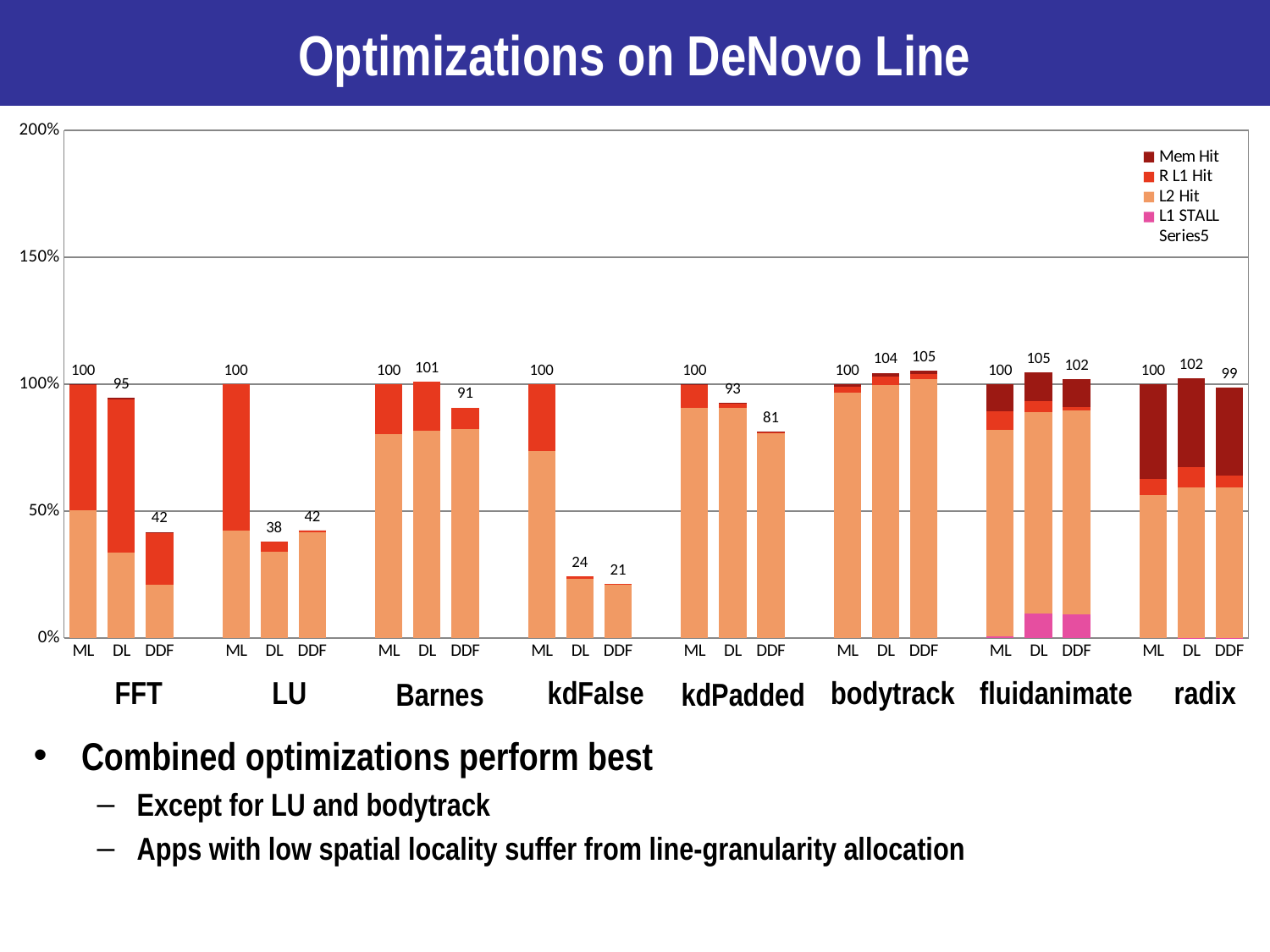
What is the total height of the DDF bar for FFT? 42 How many application groups are shown along the x axis? 8 How many series does the legend list? 5 For LU, which is larger: the DL total or the DDF total? DDF Within the kdPadded group, which configuration has the lowest total? DDF What kind of chart is shown on the slide? Stacked bar chart What is the total height of the DDF bar for radix? 99 Which bar has the lowest total across the whole chart? kdFalse DDF (21) Do the bar totals rise or fall from ML to DL to DDF within the kdFalse group? fall Is the L2 Hit segment of the FFT DL bar greater or less than 50%? less What is the title of the chart slide? Optimizations on DeNovo Line What is the difference between the ML and DL totals for kdFalse? 76